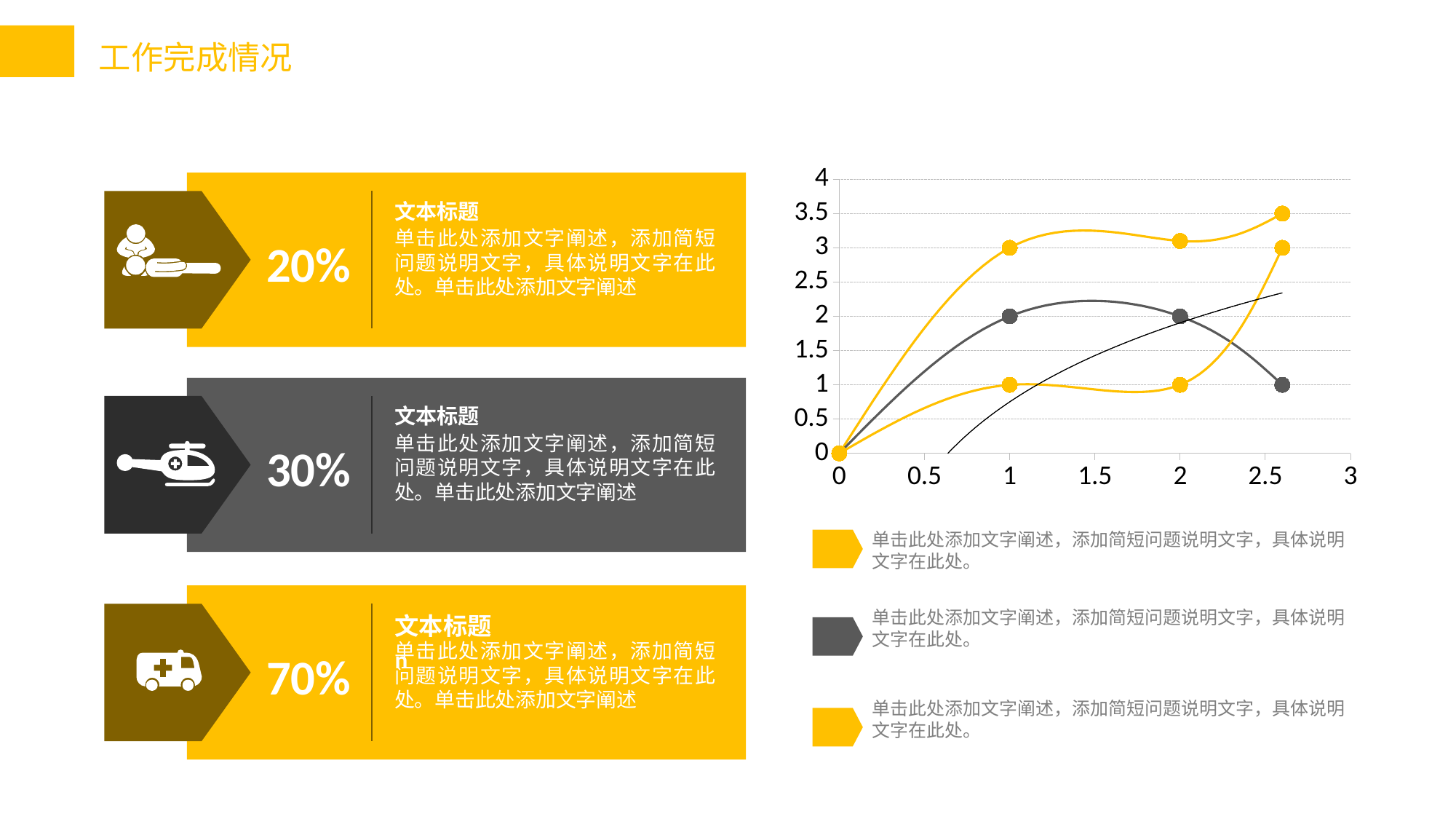
What is the value of the gray series at x = 1? 2 Which series reaches the highest value on the chart? upper yellow series What is the highest tick value shown on the y axis? 4 What is the difference between the upper yellow series and the gray series at x = 1? 1 What kind of chart is shown on the right of the slide? line chart At x = 1, which is larger: the upper yellow series or the gray series? upper yellow series Does the gray series rise or fall between x = 2 and its last point? fall What is the value of the lower yellow series at x = 1? 1 What is the value of the rightmost point of the upper yellow series? 3.5 What is the value of the rightmost point of the gray series? 1 What is the value of the upper yellow series at x = 1? 3 Is the value of the upper yellow series at x = 2 greater or less than 2.5? greater